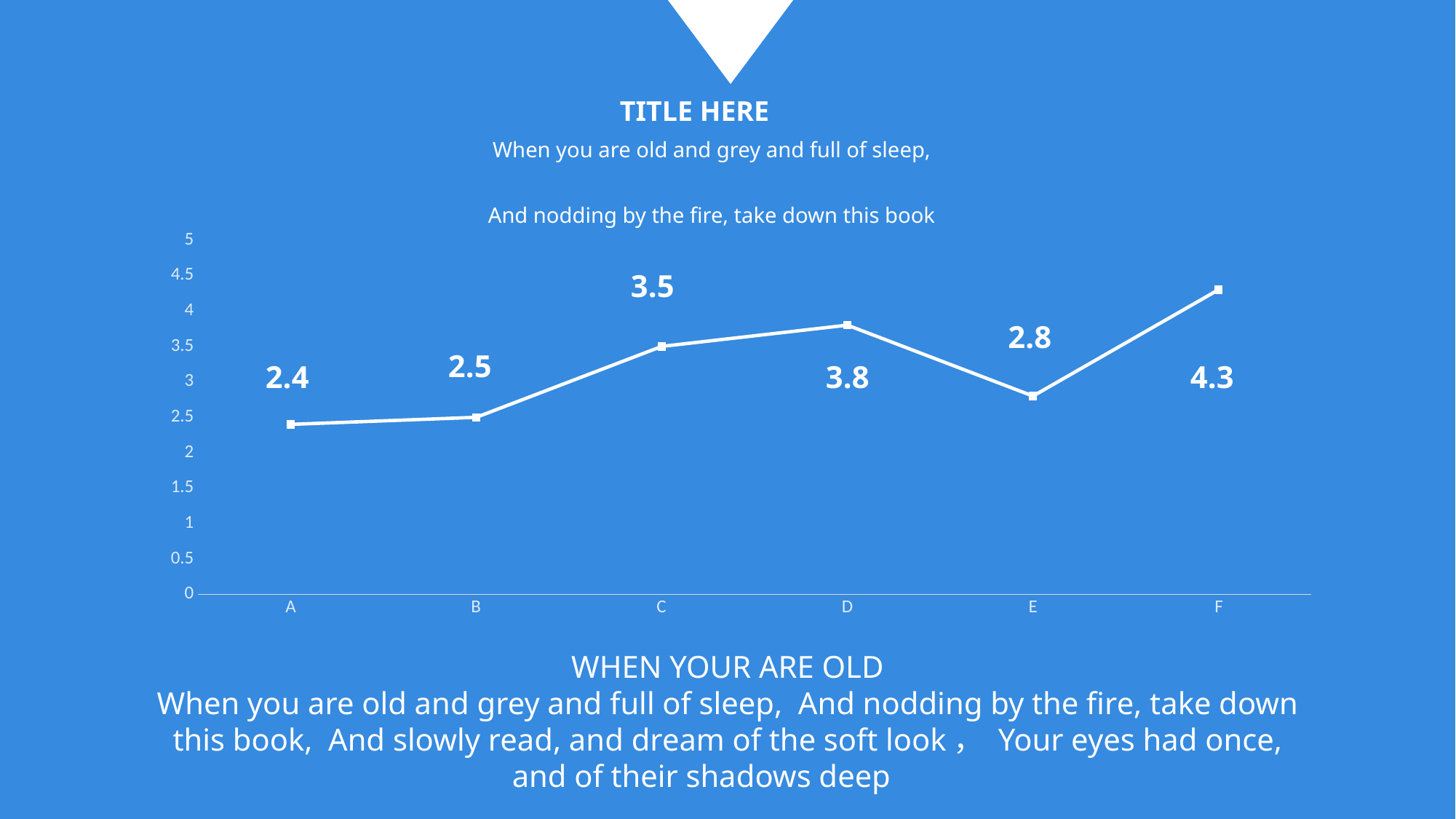
What is the difference between the values for C and B? 1 What is the value for category A? 2.4 What is the value for category C? 3.5 Does the line rise or fall from D to E? fall What is the value for category E? 2.8 What kind of chart is shown on the slide? line chart What is the difference between the values for F and D? 0.5 How many categories are plotted on the x axis? 6 Which category has the lowest value? A Which category has the highest value? F Is the value for F greater or less than 4? greater Which is larger, the value for D or the value for E? D